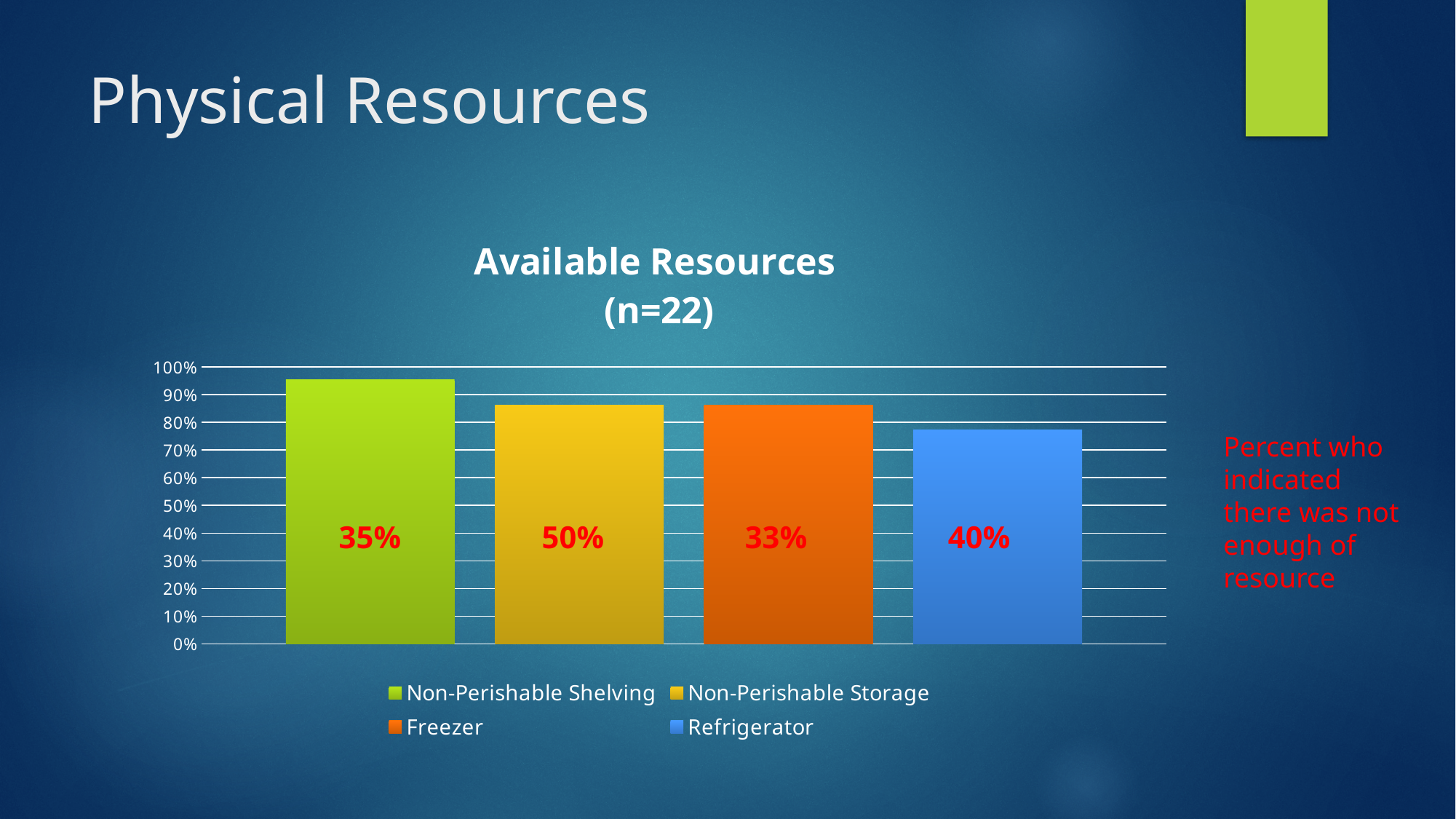
What red percentage is printed inside the Non-Perishable Storage bar? 50% What red percentage is printed inside the Freezer bar? 33% How many bars are plotted in the chart? 4 What is the title of the chart? Available Resources (n=22) How many entries does the chart legend list? 4 Which bar is taller, Non-Perishable Shelving or Refrigerator? Non-Perishable Shelving Is the bar for Freezer greater or less than 90%? less Which category has the shortest bar? Refrigerator Which category has the tallest bar? Non-Perishable Shelving What type of chart is shown on the slide? bar chart Is the bar for Non-Perishable Shelving greater or less than 90%? greater Is the bar for Refrigerator greater or less than 80%? less